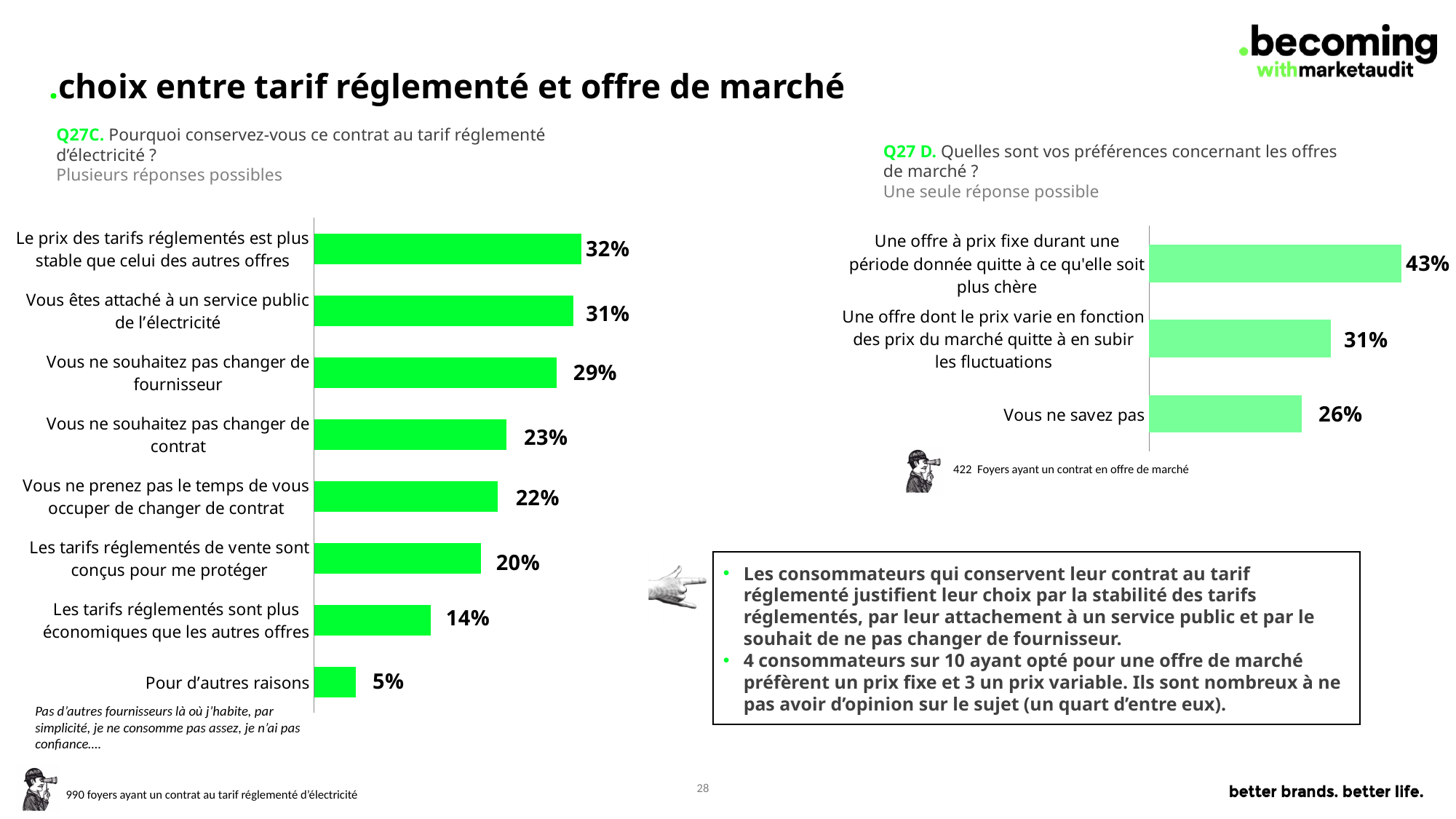
In the Q27C chart on the left, what is the difference between "Vous ne souhaitez pas changer de fournisseur" and "Les tarifs réglementés sont plus économiques que les autres offres"? 15% In the Q27C chart on the left, how many categories are shown? 8 Which is larger: "Vous ne souhaitez pas changer de contrat" in the Q27C chart or "Vous ne savez pas" in the Q27 D chart? Vous ne savez pas (26%) In the Q27 D chart on the right, what is the value for "Vous ne savez pas"? 26% In the Q27C chart on the left, which category has the lowest value? Pour d'autres raisons In the Q27C chart on the left, what is the value for "Vous êtes attaché à un service public de l'électricité"? 31% In the Q27 D chart on the right, which category has the highest value? Une offre à prix fixe durant une période donnée quitte à ce qu'elle soit plus chère In the Q27 D chart on the right, how many categories are shown? 3 In the Q27C chart on the left, what is the value for "Vous ne prenez pas le temps de vous occuper de changer de contrat"? 22% In the Q27 D chart on the right, what is the difference between the fixed-price offer (43%) and the variable-price offer (31%)? 12% In the Q27C chart on the left, which category has the highest value? Le prix des tarifs réglementés est plus stable que celui des autres offres What type of chart is the Q27C chart on the left? Bar chart